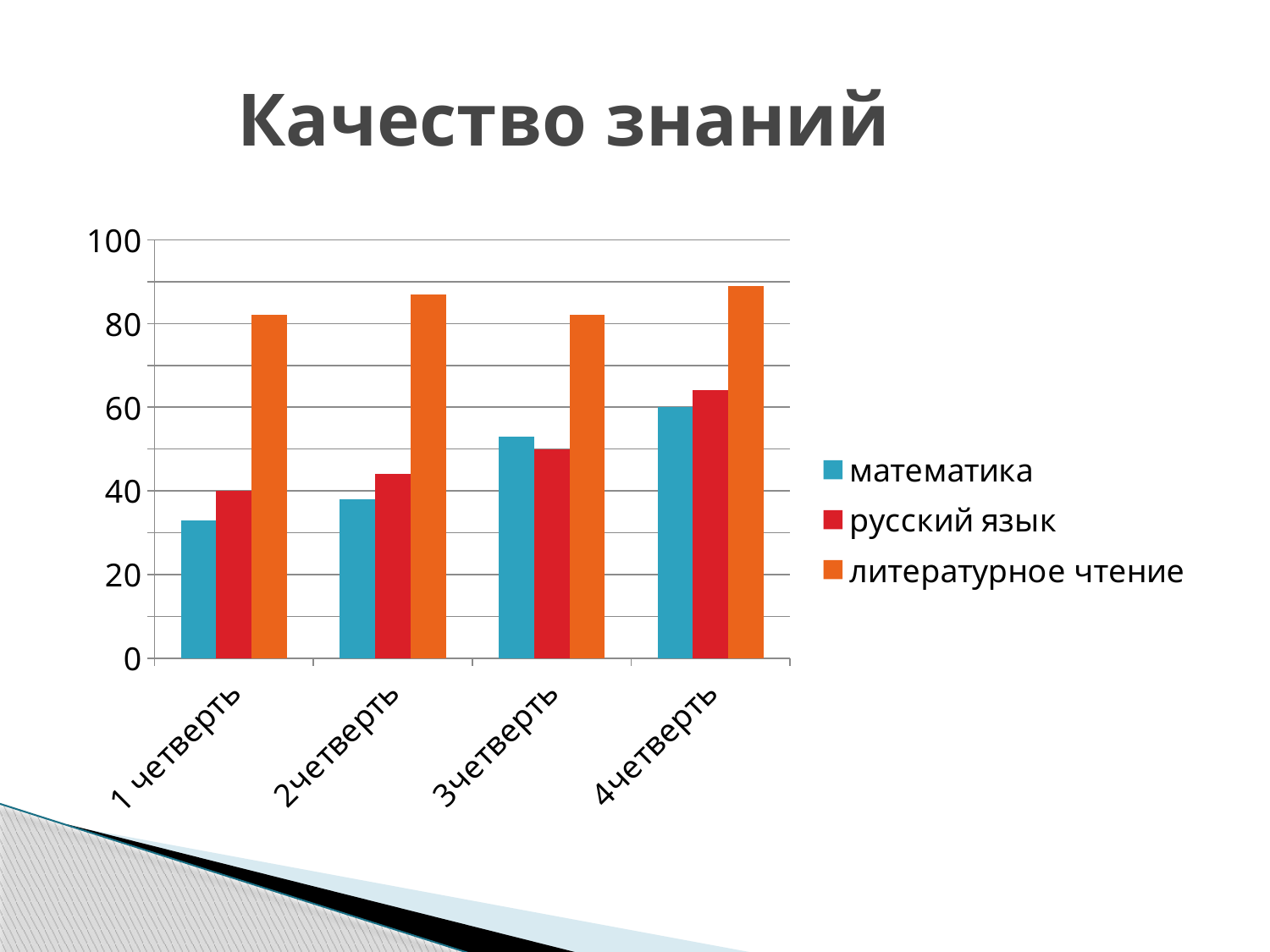
Is the value for математика in 1 четверть greater or less than 40? less How many series does the legend list? 3 What is the title of the chart? Качество знаний Is the value for литературное чтение in 2четверть greater or less than 80? greater How many categories (quarters) are shown on the x axis? 4 What kind of chart is shown on the slide? bar chart Is the value for математика in 3четверть greater or less than 40? greater In which quarter is the value for математика the highest? 4четверть In which quarter is the value for математика the lowest? 1 четверть Which series has the highest value in 1 четверть? литературное чтение Does the value for математика rise or fall from 1 четверть to 4четверть? rise